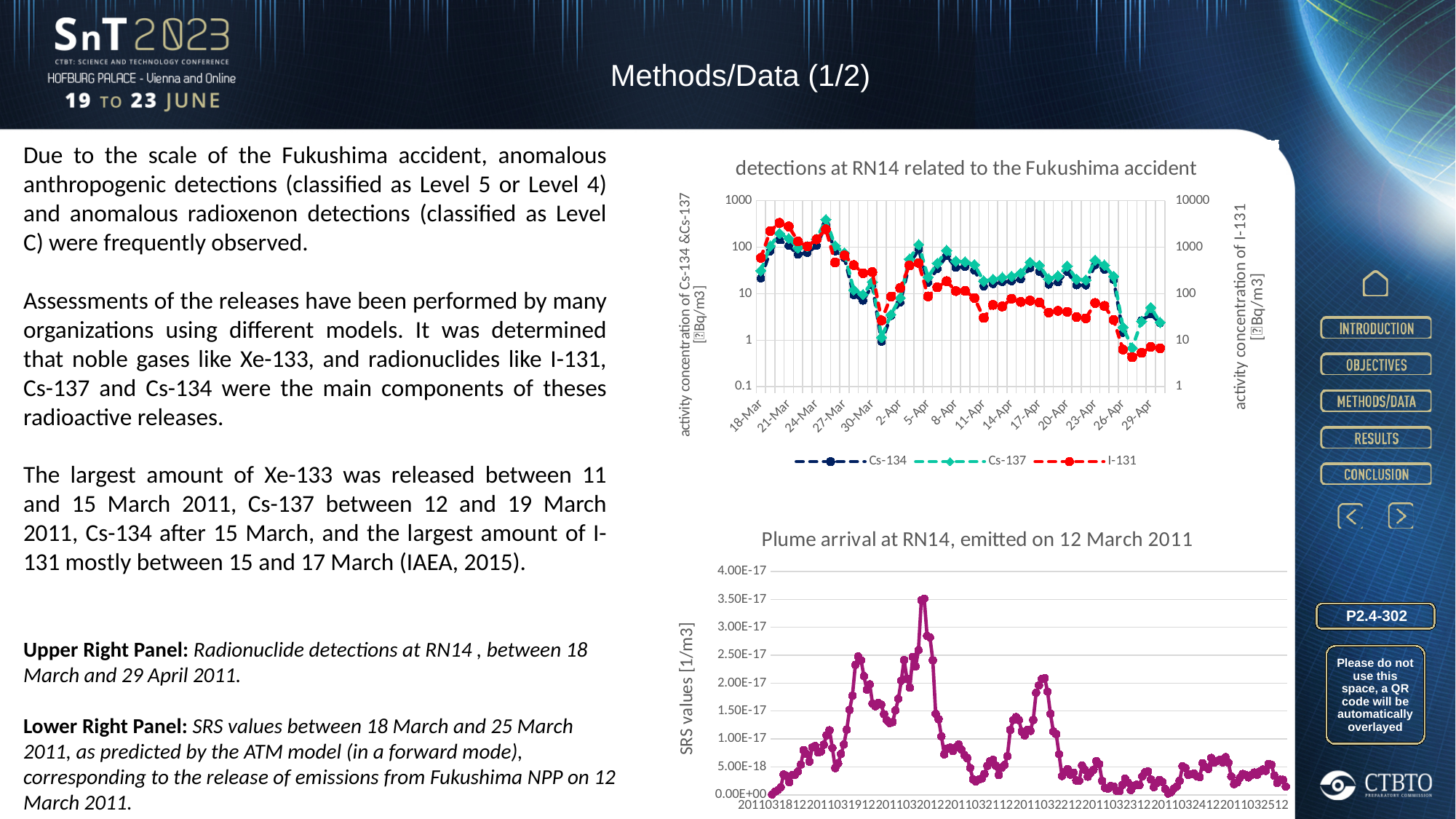
In the upper right chart, is the peak I-131 value around 21-Mar greater or less than 1000 on the right axis? greater In the upper right chart, is the Cs-134 value at 29-Apr greater or less than 10 on the left axis? less How many series does the legend of the upper right chart list? 3 In the lower right chart, is the highest SRS value greater or less than 4.00E-17? less What kind of chart is the upper right chart titled 'detections at RN14 related to the Fukushima accident'? line chart What kind of chart is the lower right chart showing SRS values? line chart In the lower right chart, do the SRS values rise or fall from the main peak to the end of the series? fall What is the title of the lower right chart? Plume arrival at RN14, emitted on 12 March 2011 In the upper right chart, does the Cs-137 series end higher or lower at 29-Apr than it starts at 18-Mar? lower What are the legend entries of the upper right chart? Cs-134, Cs-137, I-131